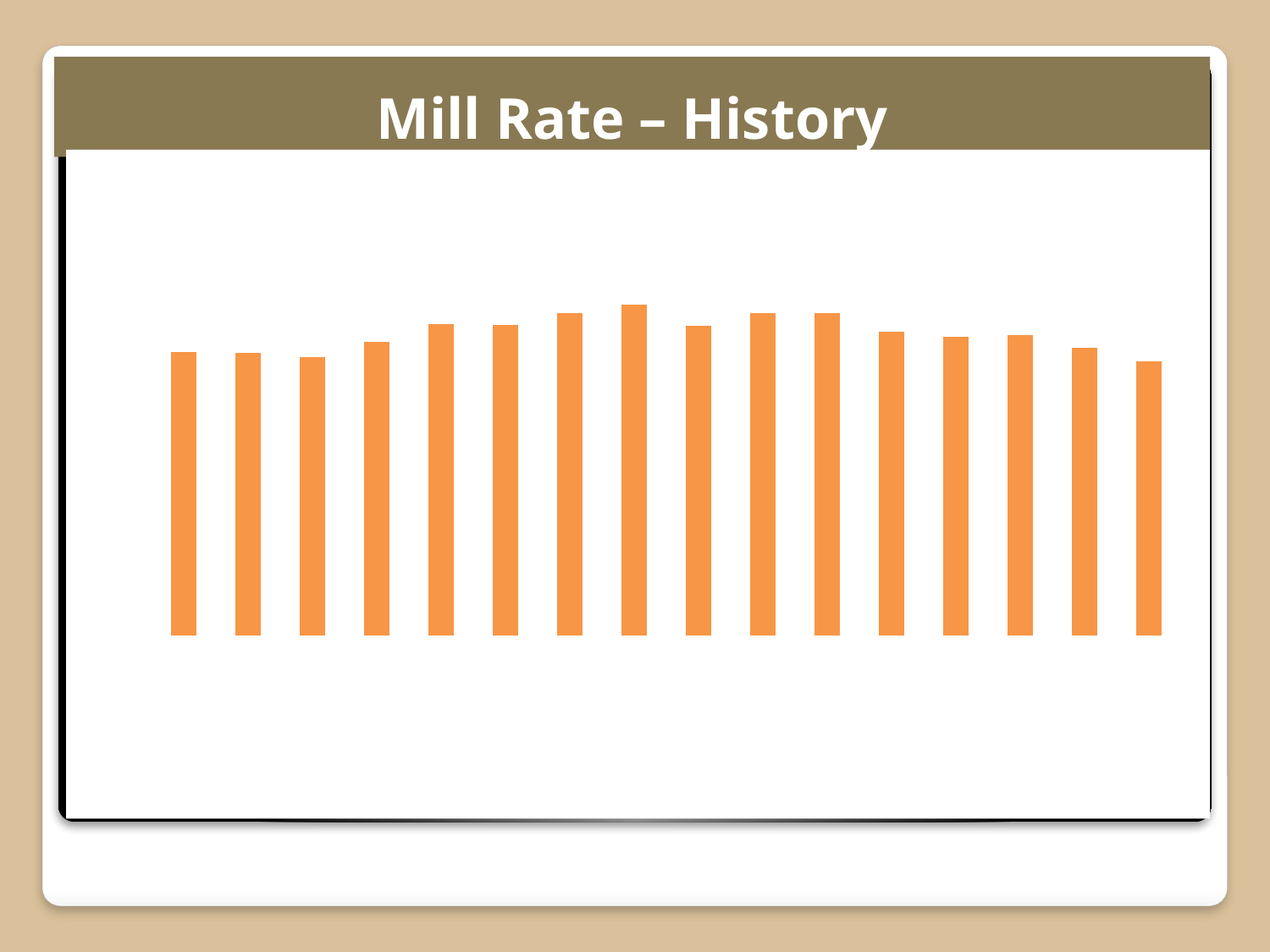
What colour are the bars in the chart? orange How many bars are plotted in the chart? 16 Is the last (rightmost) bar taller or shorter than the first (leftmost) bar? shorter Counting from the left, which bar is the tallest in the chart? the 8th bar What kind of chart is shown on the slide? bar chart What is the title of the chart on the slide? Mill Rate – History Do the bars rise or fall from the 8th bar to the last bar on the right? fall